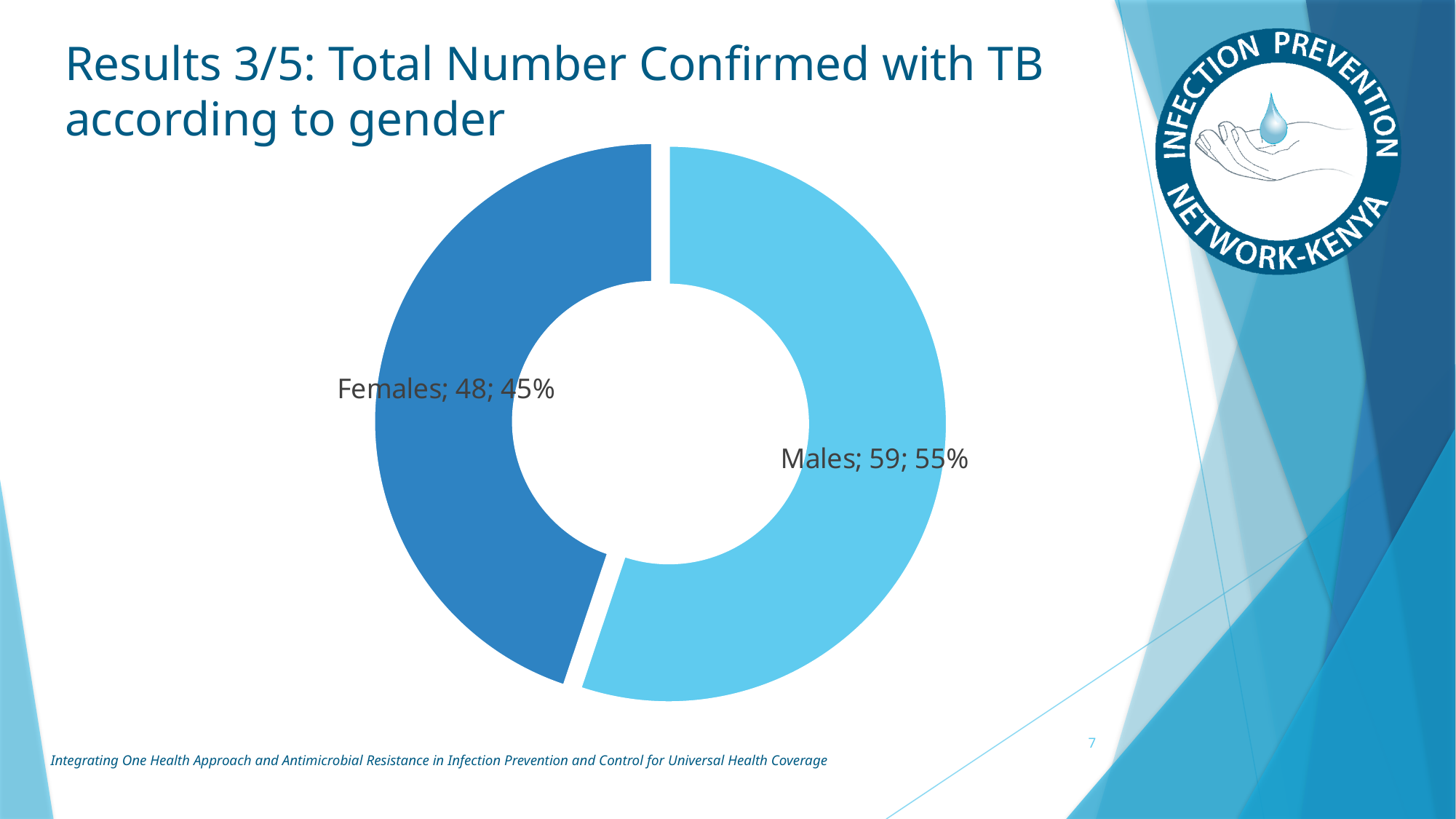
Which gender has the higher number of confirmed TB cases? Males What is the difference between the number of Males and Females confirmed with TB? 11 What percentage of confirmed TB cases are Females? 45% How many categories does the chart show? 2 How many confirmed TB cases are shown for Females? 48 What is the total number of confirmed TB cases shown in the chart? 107 Is the number of Females confirmed with TB greater or less than the number of Males? less Which slice is shown in the darker blue colour? Females What percentage of confirmed TB cases are Males? 55% What kind of chart is shown on the slide? Pie chart (doughnut) How many confirmed TB cases are shown for Males? 59 Which gender has the lower number of confirmed TB cases? Females